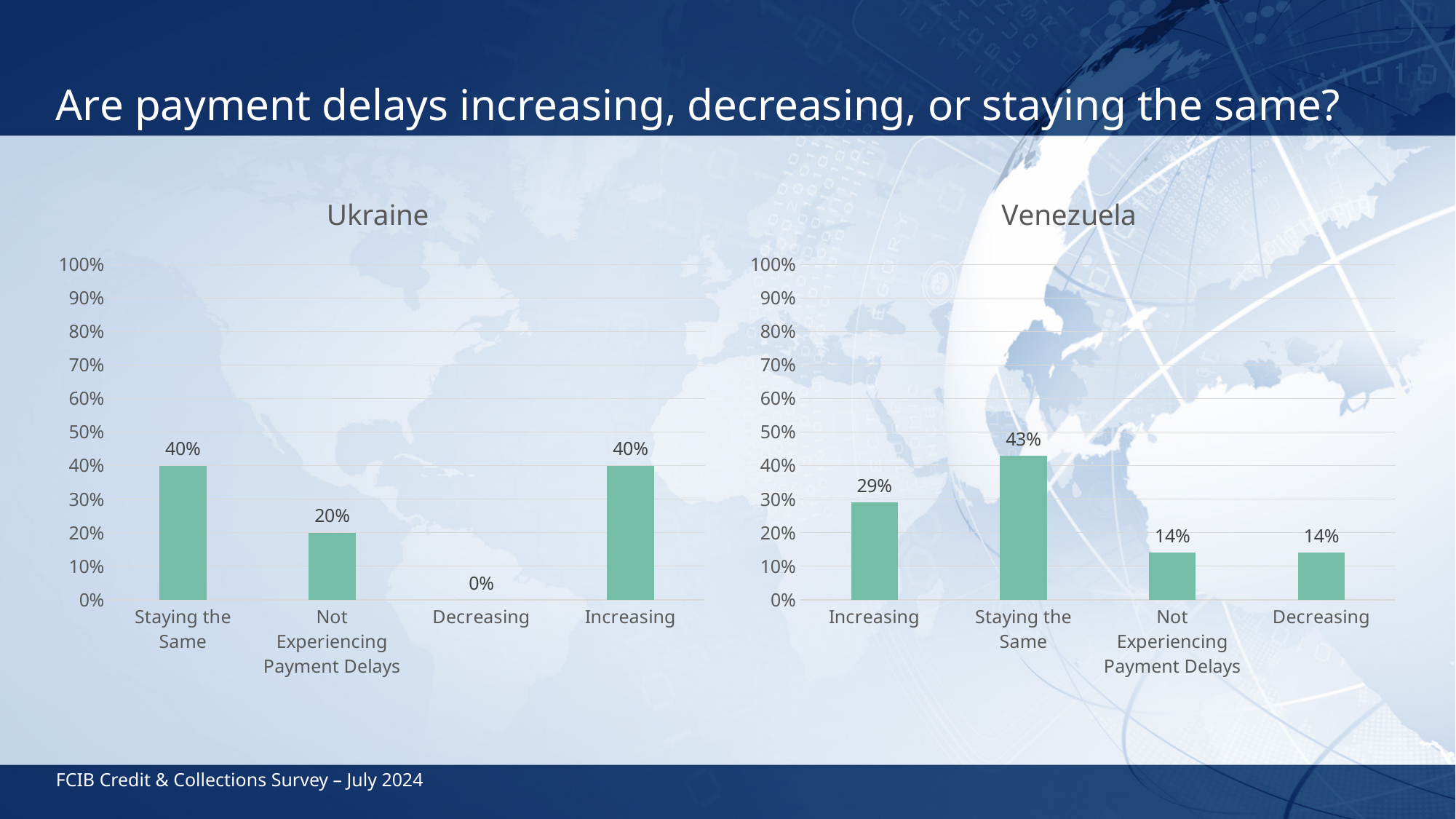
In the Venezuela chart, what is the value for Staying the Same? 43% In the Ukraine chart, what is the value for Decreasing? 0% In the Venezuela chart, what is the value for Increasing? 29% In the Venezuela chart, what is the difference between Staying the Same and Increasing? 14% In the Ukraine chart, what is the difference between Staying the Same and Not Experiencing Payment Delays? 20% In the Venezuela chart, which is larger: Increasing or Decreasing? Increasing In the Ukraine chart, what is the value for Not Experiencing Payment Delays? 20% In the Venezuela chart, which category has the highest value? Staying the Same What is the title of the chart on the right side of the slide? Venezuela How many categories does the Venezuela chart show? 4 What kind of chart is the Ukraine chart? Bar chart In the Ukraine chart, which category has the lowest value? Decreasing